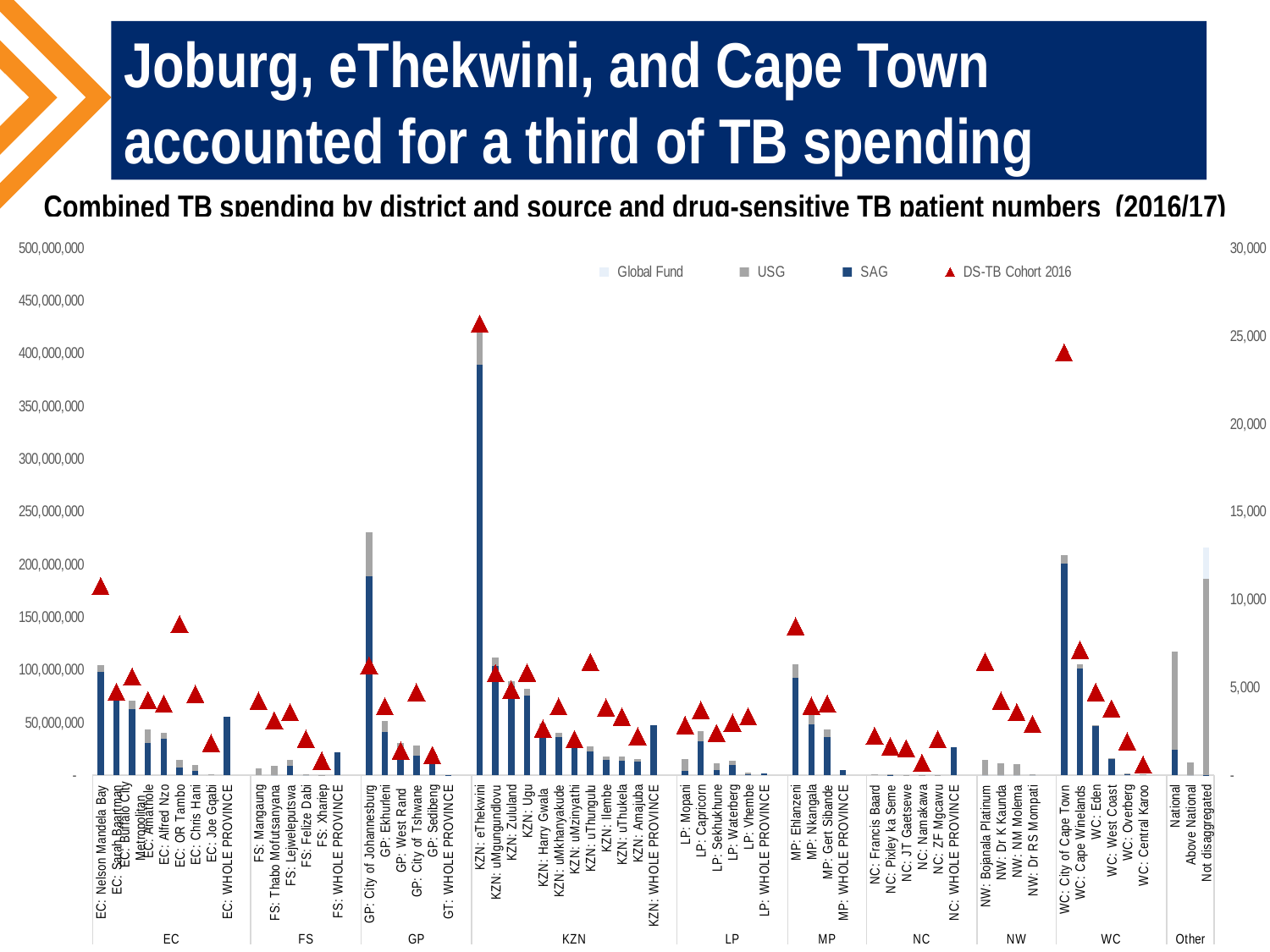
How many series does the legend list? 4 Which series is plotted as red triangles? DS-TB Cohort 2016 Is the total spending bar for GP: City of Johannesburg greater or less than 200,000,000? greater Which has the taller spending bar, KZN: eThekwini or GP: City of Johannesburg? KZN: eThekwini Which district has the highest DS-TB Cohort 2016 marker? KZN: eThekwini How many province groups are labelled along the bottom of the chart? 10 Which district has the tallest spending bar? KZN: eThekwini What kind of chart is shown on the slide? combination chart: stacked bar chart with triangle markers Is the total spending bar for KZN: eThekwini greater or less than 400,000,000? greater What is the highest value shown on the right-hand axis? 30,000 Is the DS-TB Cohort 2016 value for WC: City of Cape Town greater or less than 20,000? greater